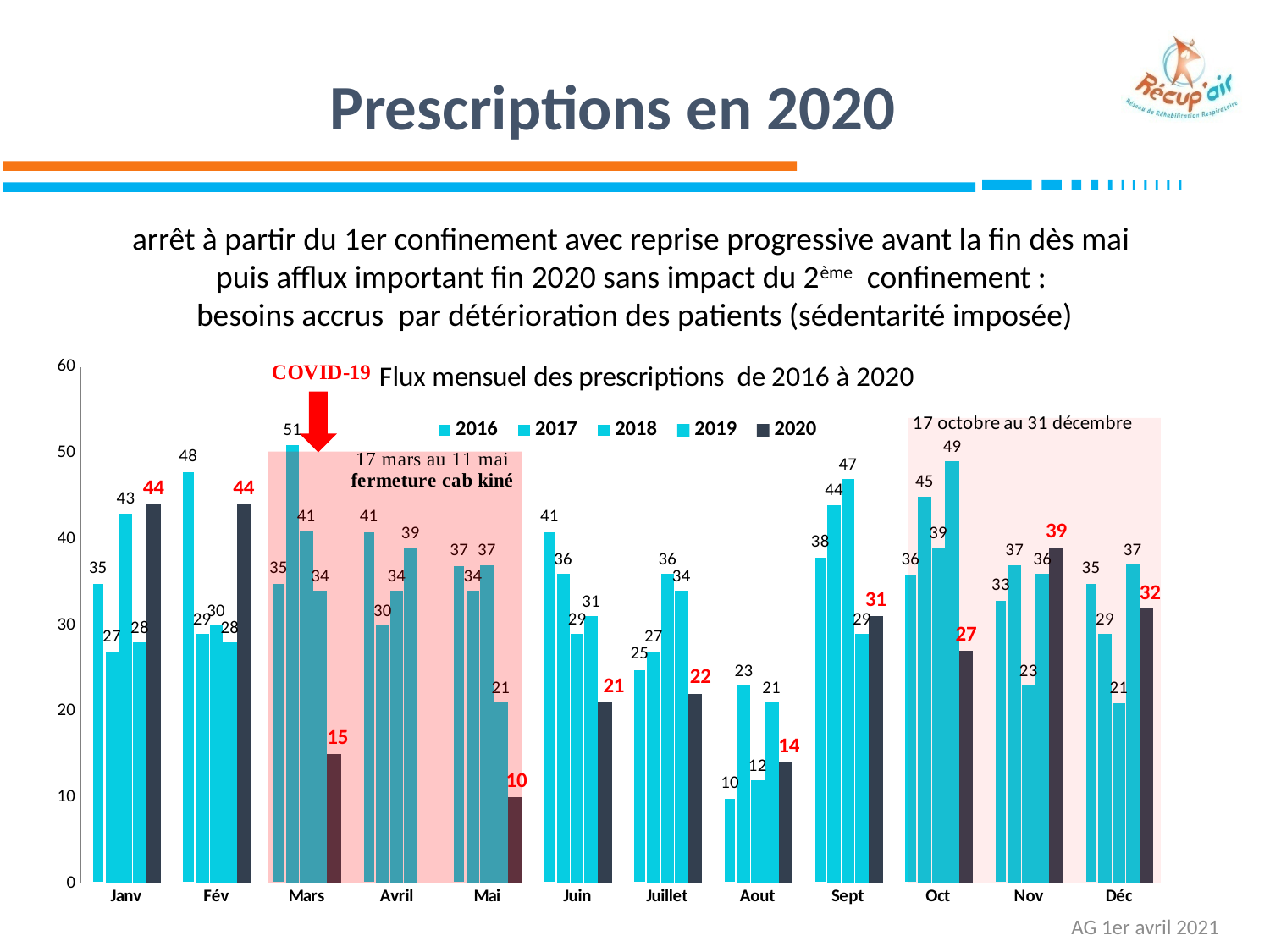
What is the difference between the 2017 and 2020 values for Mars? 36 What is the 2020 value for Nov? 39 What is the title of the chart? Flux mensuel des prescriptions de 2016 à 2020 What is the difference between the 2020 values for Janv and Mai? 34 What is the 2019 value for Oct? 49 How many series does the legend list? 5 What is the 2017 value for Mars? 51 For Sept, which is larger: the 2018 value or the 2019 value? 2018 How many months are shown on the x axis? 12 What kind of chart is shown on the slide? bar chart Which month has the lowest 2020 value? Mai What is the 2020 value for Mars? 15